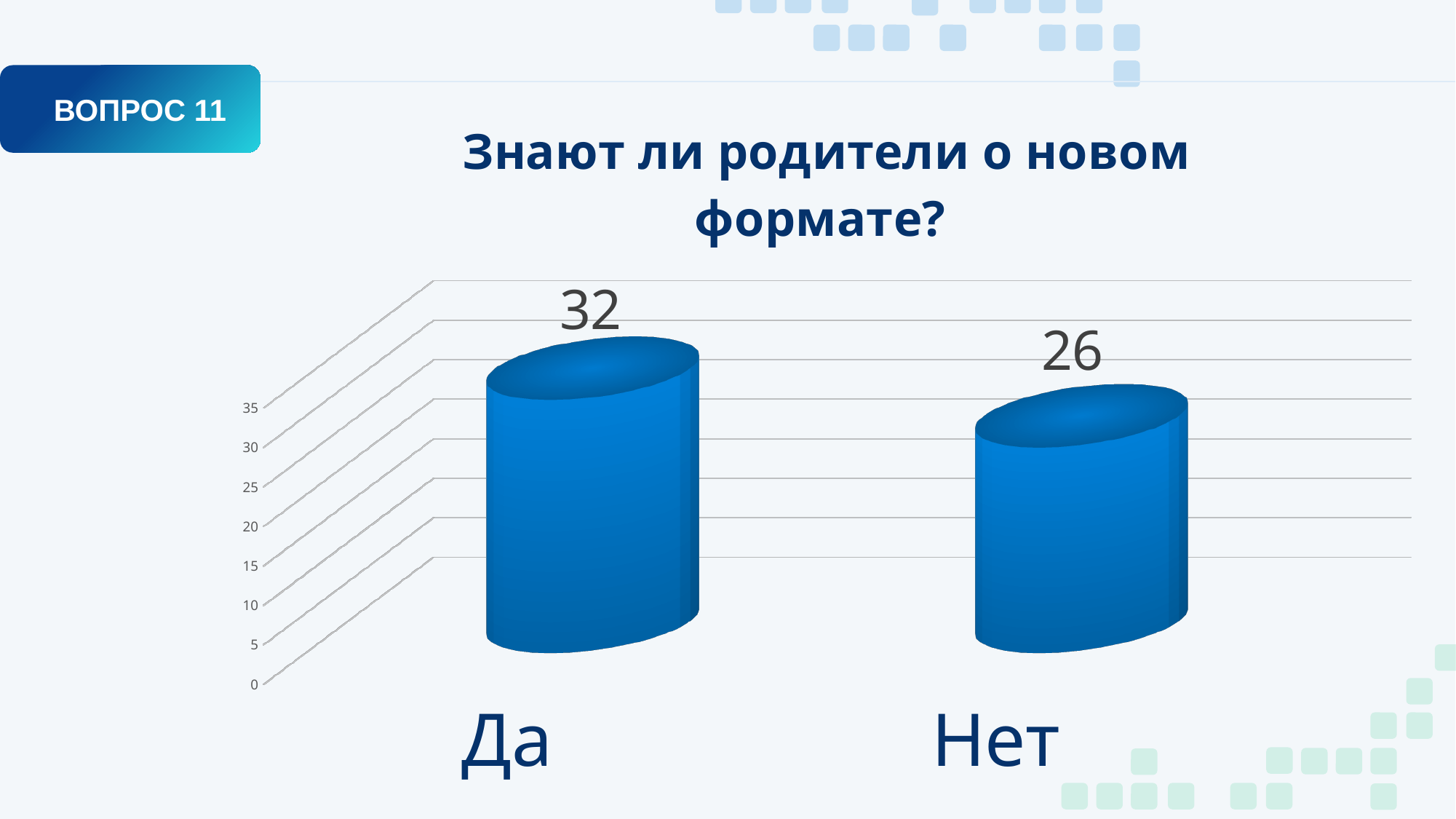
What is the title of the chart? Знают ли родители о новом формате? Is the value for "Нет" greater or less than 30? less Which is larger, the value for "Да" or the value for "Нет"? Да What is the value for "Да"? 32 What is the total of the two values shown in the chart? 58 What is the difference between the values for "Да" and "Нет"? 6 What kind of chart is shown on the slide? bar chart Which category has the highest value? Да Is the value for "Да" greater or less than 30? greater How many categories are shown in the chart? 2 What is the value for "Нет"? 26 Which category has the lowest value? Нет